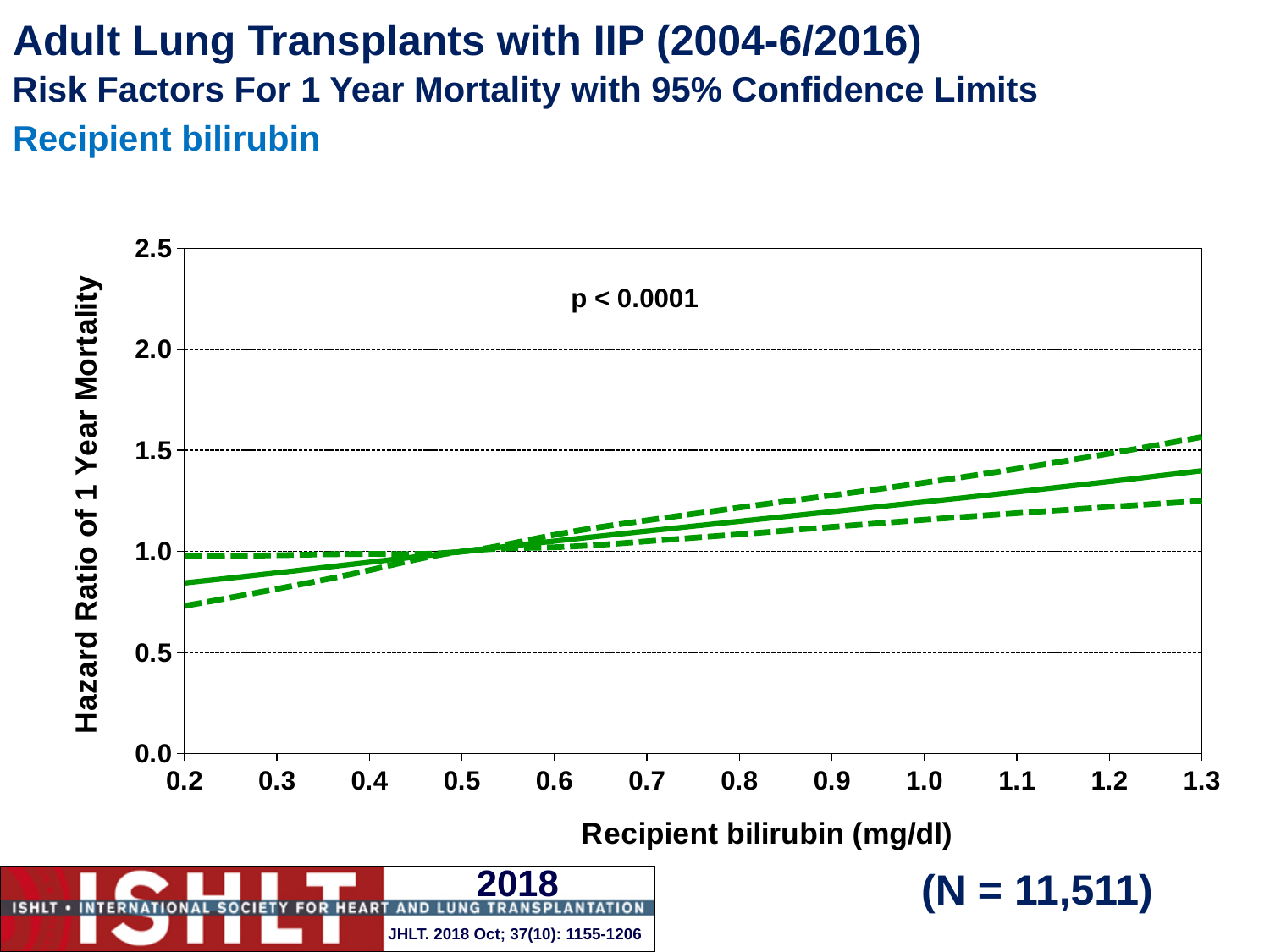
Is the hazard ratio for a recipient bilirubin of 0.2 mg/dl greater or less than 1.0? less Is the hazard ratio for a recipient bilirubin of 1.3 mg/dl greater or less than 1.0? greater What is the label of the x axis? Recipient bilirubin (mg/dl) What p-value is printed on the chart? p < 0.0001 Is the lower 95% confidence limit at a recipient bilirubin of 0.2 mg/dl greater or less than 0.5? greater What kind of chart is shown on the slide? line chart Which recipient bilirubin value has the higher hazard ratio, 0.2 mg/dl or 1.3 mg/dl? 1.3 mg/dl Does the hazard ratio of 1 year mortality rise or fall as recipient bilirubin increases along the x axis? rise How many tick labels are shown on the x axis? 12